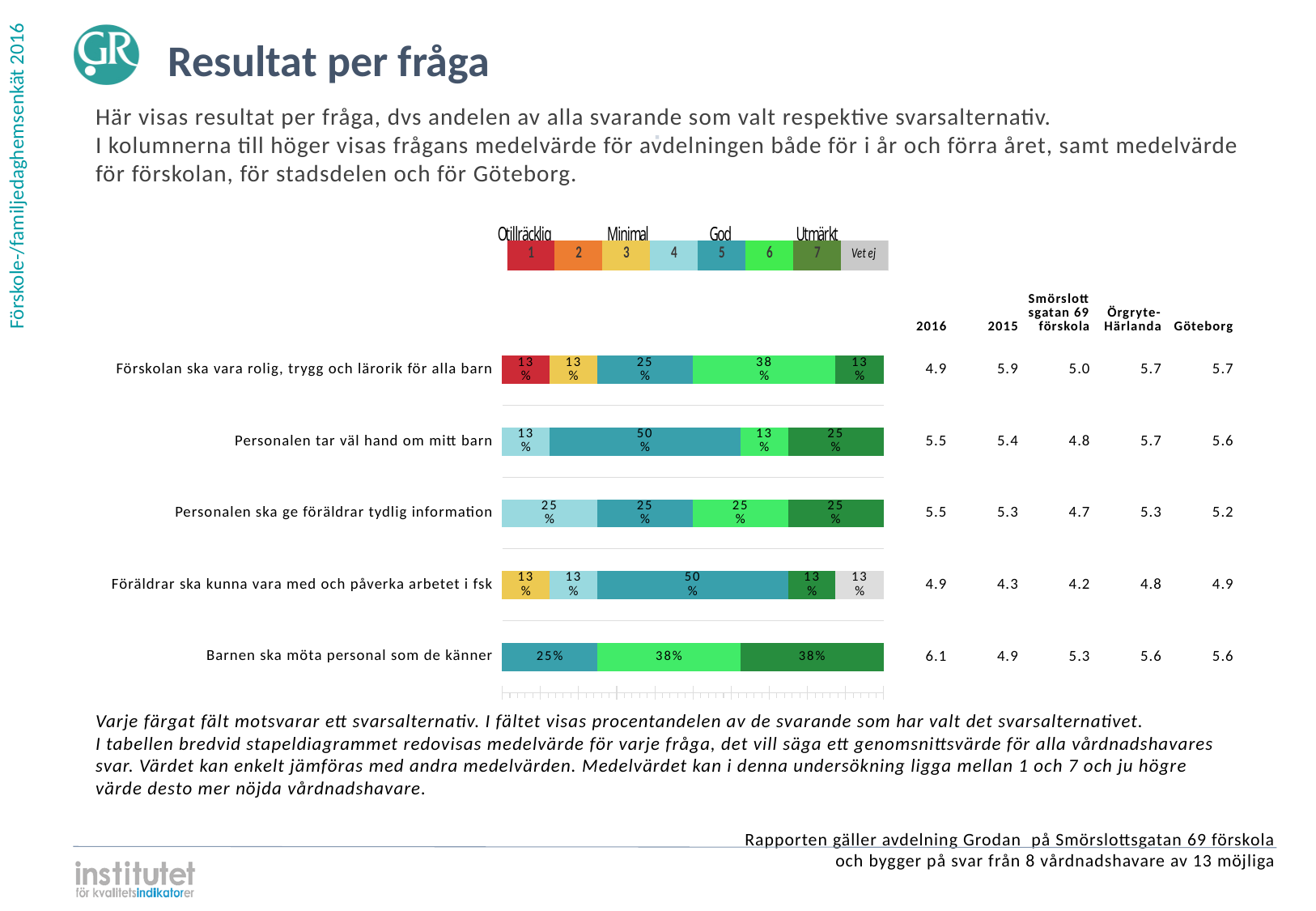
Which legend label is shown above answer alternatives 6 and 7? Utmärkt What is the 2016 mean value shown for 'Barnen ska möta personal som de känner'? 6.1 Which question has the lowest 2015 mean value in the table? Föräldrar ska kunna vara med och påverka arbetet i fsk What percentage of respondents chose alternative 6 (bright green) for 'Förskolan ska vara rolig, trygg och lärorik för alla barn'? 38% For 'Personalen ska ge föräldrar tydlig information', which is larger: the share for alternative 4 or the share for alternative 7? They are equal (25% each) For 'Förskolan ska vara rolig, trygg och lärorik för alla barn', what is the difference between the share for alternative 6 and the share for alternative 1? 25 percentage points What percentage of respondents chose alternative 5 (teal) for 'Personalen tar väl hand om mitt barn'? 50% What kind of chart is used to show the share of respondents per answer alternative? Stacked bar chart How many answer alternatives does the legend above the chart list (including 'Vet ej')? 8 What percentage of respondents chose alternative 7 (dark green) for 'Barnen ska möta personal som de känner'? 38% How many questions (categories) are shown as bars in the chart? 5 What percentage of respondents answered 'Vet ej' for 'Föräldrar ska kunna vara med och påverka arbetet i fsk'? 13%